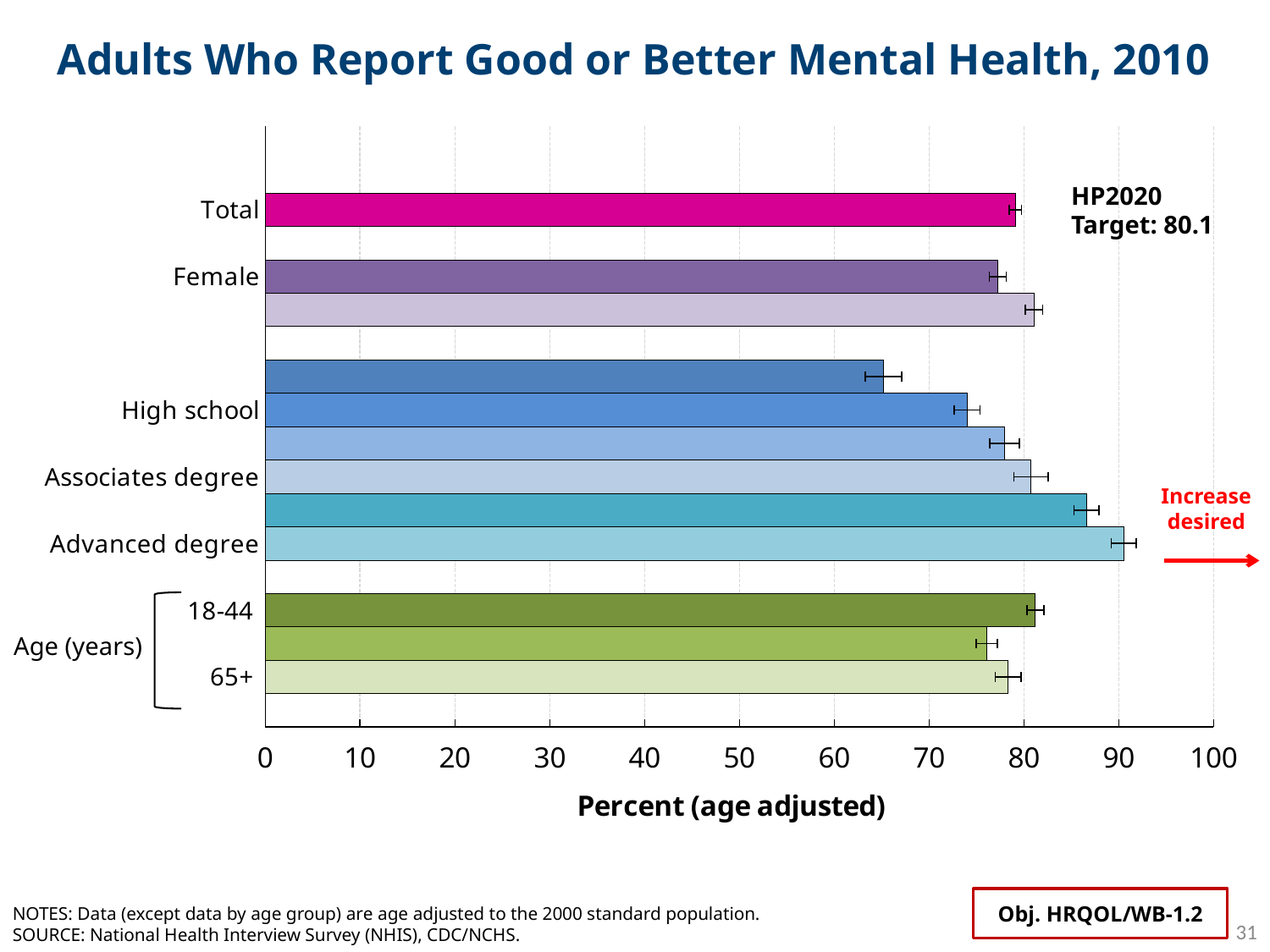
Is the value for Advanced degree greater or less than 80? greater Which is larger, the value for 18-44 or the value for 65+? 18-44 Which category has the longest bar in the chart? Advanced degree Is the value for Female greater or less than 70? greater What is the title of the x axis? Percent (age adjusted) Is the value for 65+ greater or less than 80? less Which is larger, the value for Advanced degree or the value for High school? Advanced degree What is the HP2020 target shown on the chart? 80.1 What kind of chart is shown on the slide? bar chart Which is larger, the value for Total or the value for High school? Total